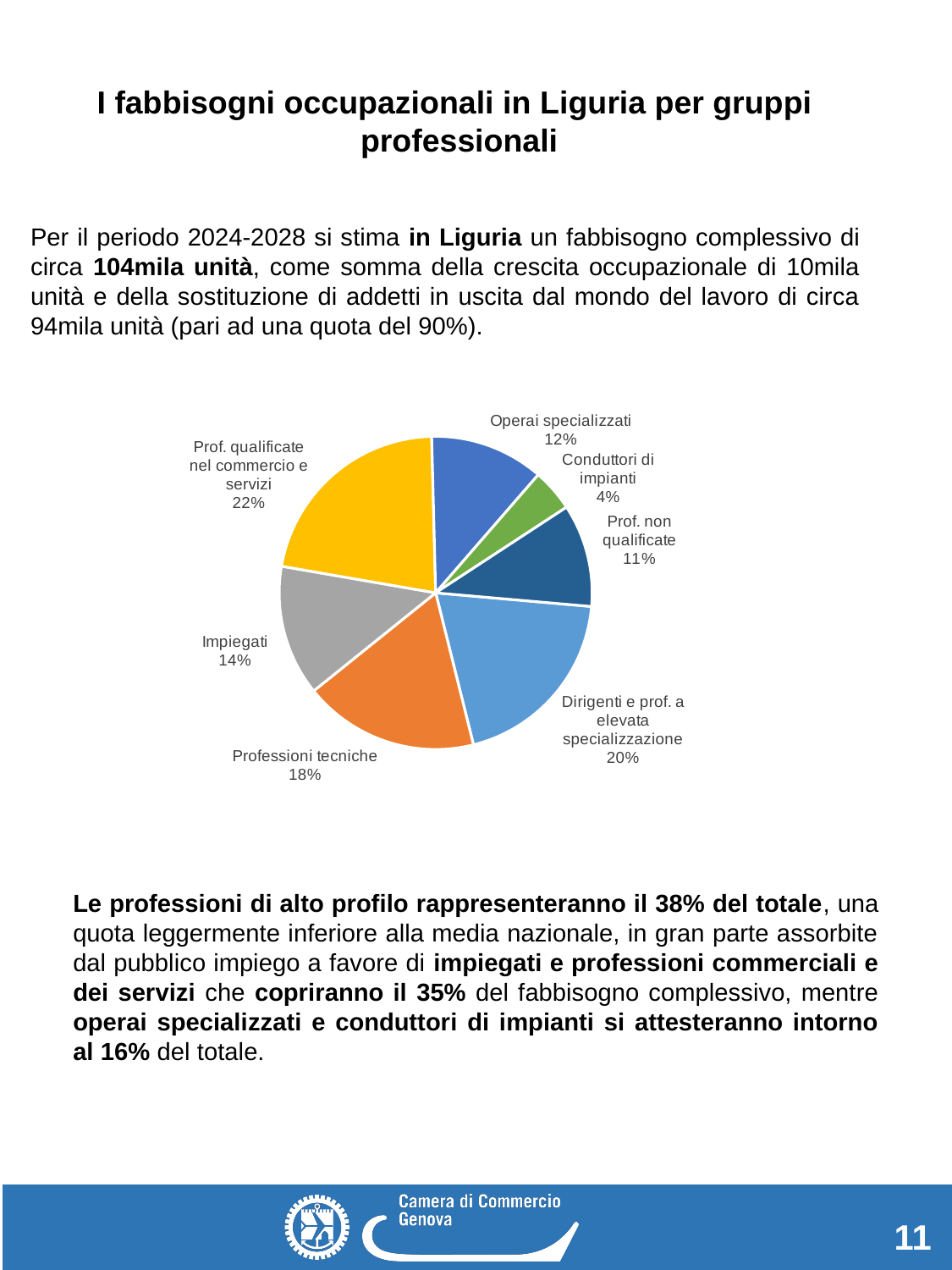
Which category has the smallest slice of the pie? Conduttori di impianti What share of the pie does "Prof. qualificate nel commercio e servizi" represent? 22% What is the value shown for "Impiegati"? 14% What colour is the slice for "Professioni tecniche"? orange What is the difference in percentage points between "Prof. qualificate nel commercio e servizi" and "Conduttori di impianti"? 18 Which category has the largest slice of the pie? Prof. qualificate nel commercio e servizi What is the difference in percentage points between "Professioni tecniche" and "Prof. non qualificate"? 7 What is the value shown for "Operai specializzati"? 12% How many slices does the pie chart have? 7 What kind of chart is shown on the slide? pie chart Which is larger, the slice for "Impiegati" or the slice for "Operai specializzati"? Impiegati What is the value shown for "Dirigenti e prof. a elevata specializzazione"? 20%